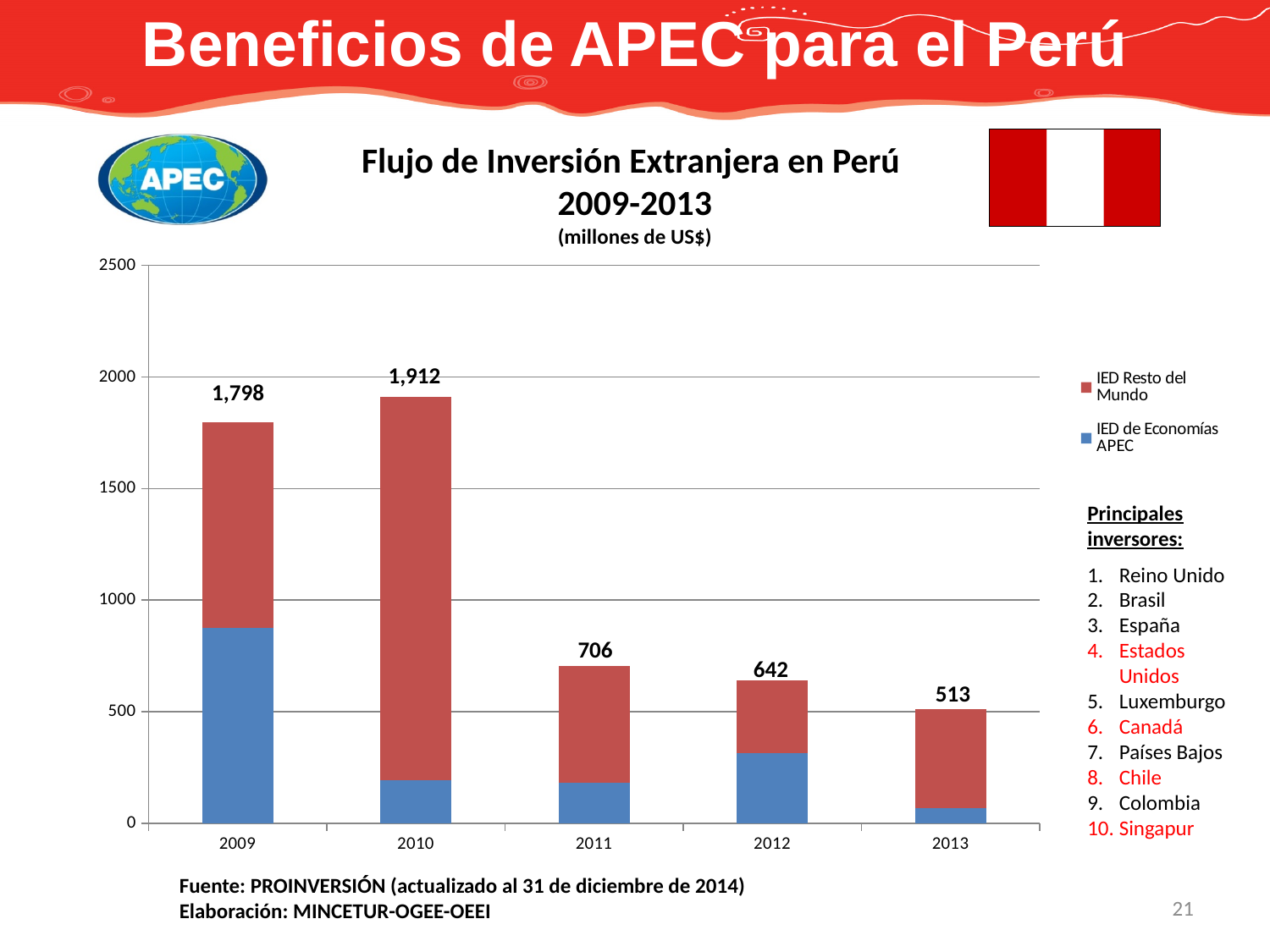
Which year has the lowest total foreign investment flow? 2013 How many series does the chart legend list? 2 What is the total value labelled on the bar for 2013? 513 Is the value of the IED de Economías APEC segment for 2012 greater or less than 500? less Which year has the highest total foreign investment flow? 2010 What is the difference between the total for 2010 and the total for 2009? 114 How many years are shown on the x axis of the chart? 5 Which year has a larger total, 2011 or 2013? 2011 What is the total foreign investment flow shown for 2010? 1,912 Is the value of the IED de Economías APEC segment for 2009 greater or less than 500? greater What is the difference between the total for 2011 and the total for 2012? 64 What kind of chart is used to show the foreign investment flow? Stacked bar chart